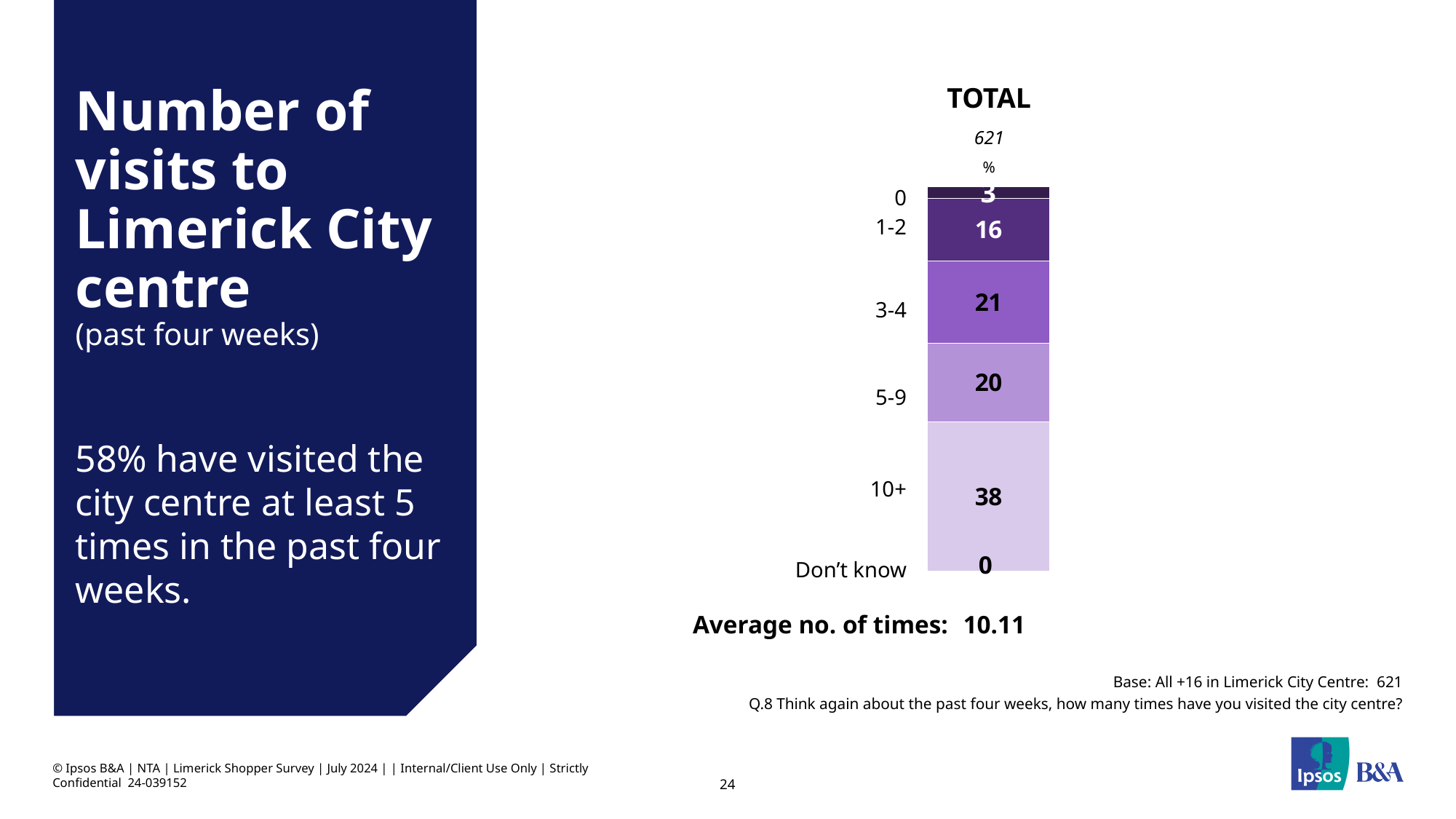
Which category has the smallest share of respondents? Don't know What kind of chart is used to show the number of visits? Stacked bar chart What percentage of respondents visited the city centre 1-2 times? 16 What is the difference in percentage points between the 10+ category and the 5-9 category? 18 Which is larger, the share for 3-4 visits or the share for 1-2 visits? 3-4 visits How many visit-frequency categories are shown in the stacked bar? 6 Which visit-frequency category has the largest share of respondents? 10+ What is the base size shown above the bar? 621 What is the average number of times respondents visited the city centre? 10.11 What percentage of respondents visited the city centre 3-4 times? 21 What percentage of respondents made 0 visits to the city centre in the past four weeks? 3 What percentage of respondents visited Limerick City centre 10+ times in the past four weeks? 38